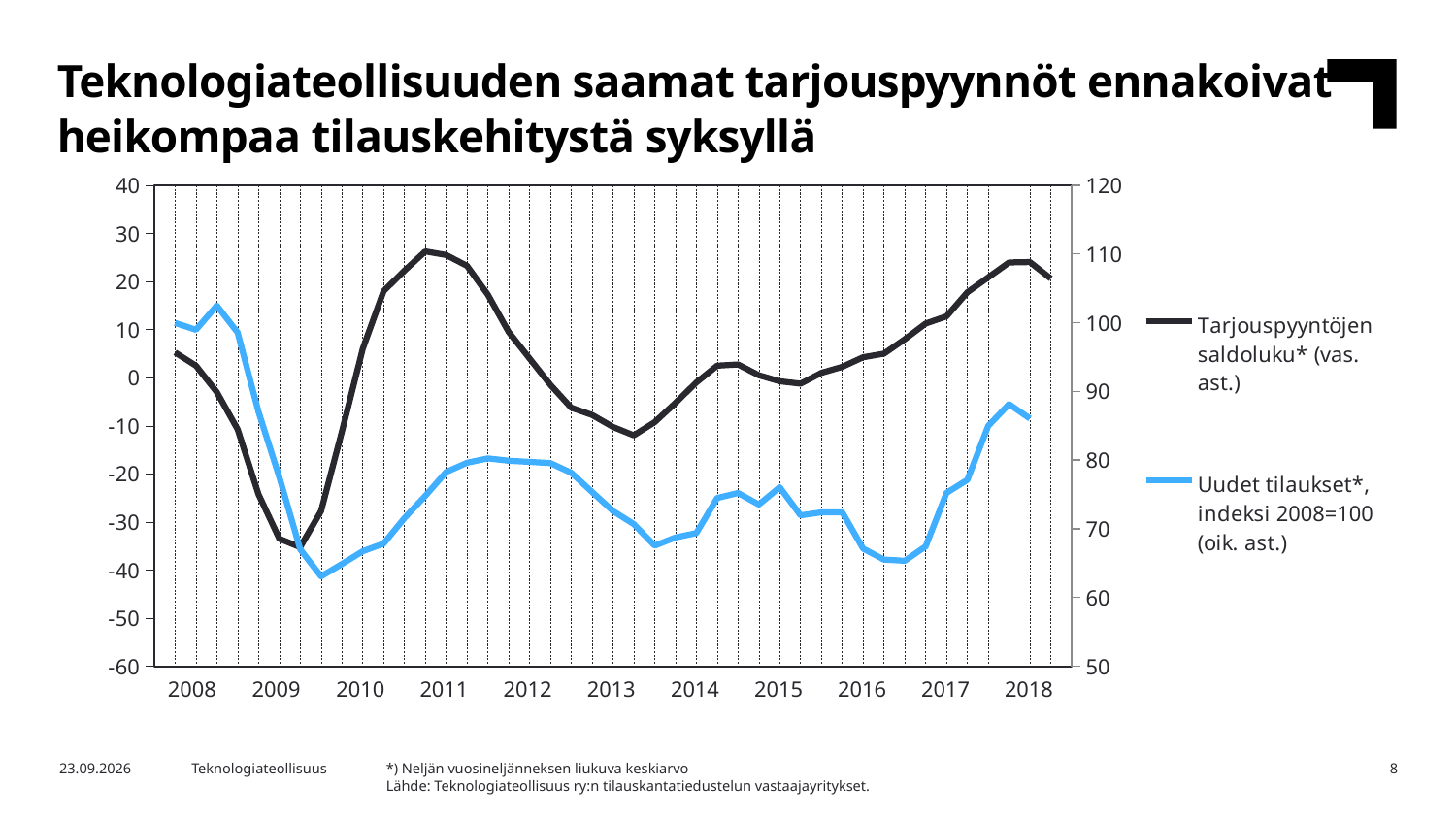
Is the lowest value of Uudet tilaukset around 2009 greater or less than 70? less Does Tarjouspyyntöjen saldoluku rise or fall from 2016 to 2018? rise Is the lowest value of Tarjouspyyntöjen saldoluku around 2009 greater or less than -30? less What kind of chart is shown on the slide? line chart In which year does Tarjouspyyntöjen saldoluku reach its lowest point? 2009 Is the value of Uudet tilaukset at the start of 2008 greater or less than 90? greater Is Tarjouspyyntöjen saldoluku higher in 2011 or in 2013? 2011 How many series does the legend list? 2 What are the two series named in the legend? Tarjouspyyntöjen saldoluku* (vas. ast.) and Uudet tilaukset*, indeksi 2008=100 (oik. ast.) How many years are labelled on the x axis? 11 In which year does Uudet tilaukset reach its lowest point? 2009